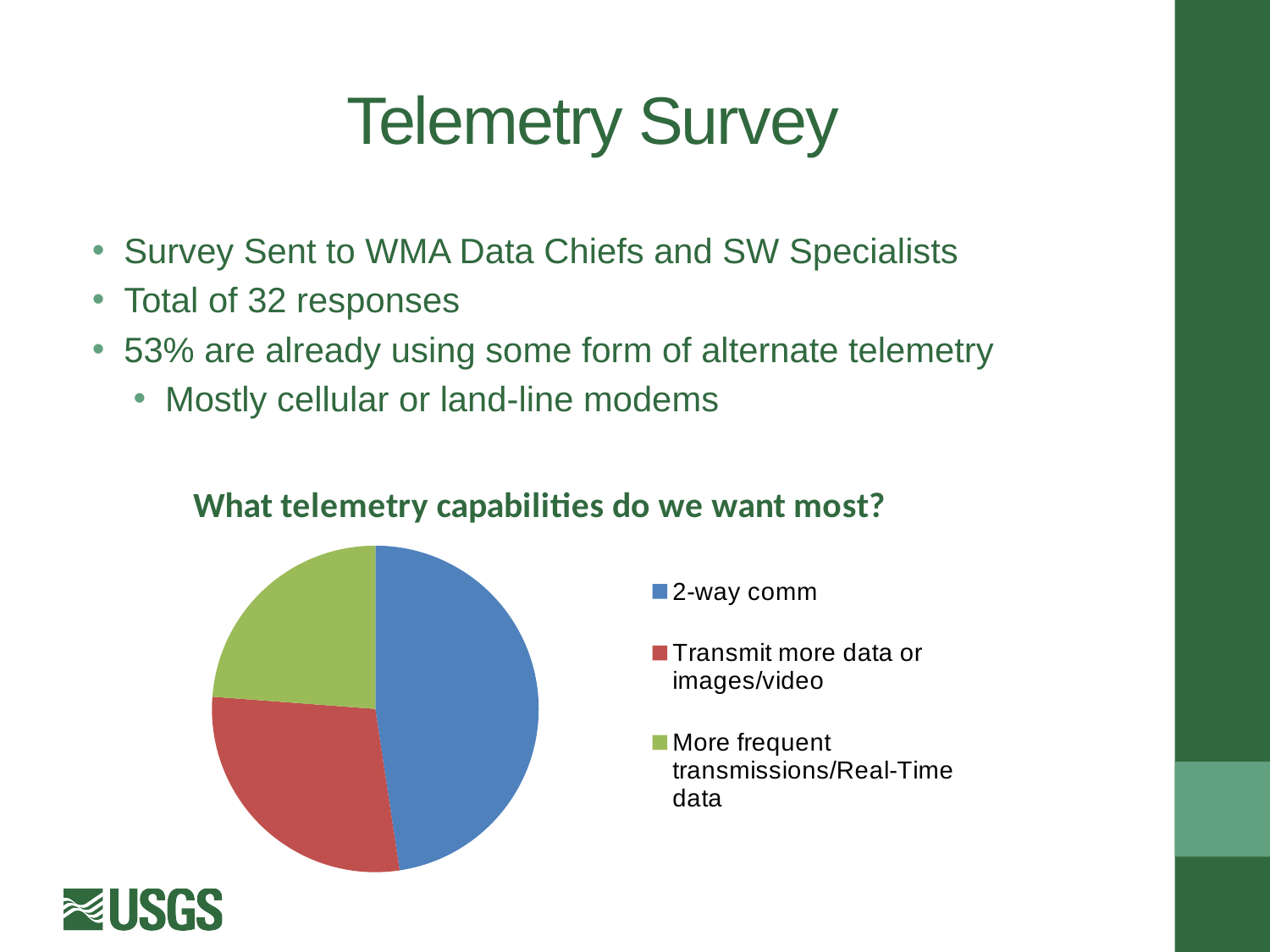
How many entries does the pie chart's legend list? 3 How many slices does the pie chart have? 3 What kind of chart is shown on the slide? pie chart Which telemetry capability has the largest slice in the pie chart? 2-way comm What is the title of the pie chart? What telemetry capabilities do we want most? Which slice is larger: 2-way comm or More frequent transmissions/Real-Time data? 2-way comm Which slice is larger: 2-way comm or Transmit more data or images/video? 2-way comm What colour represents 2-way comm in the pie chart? blue